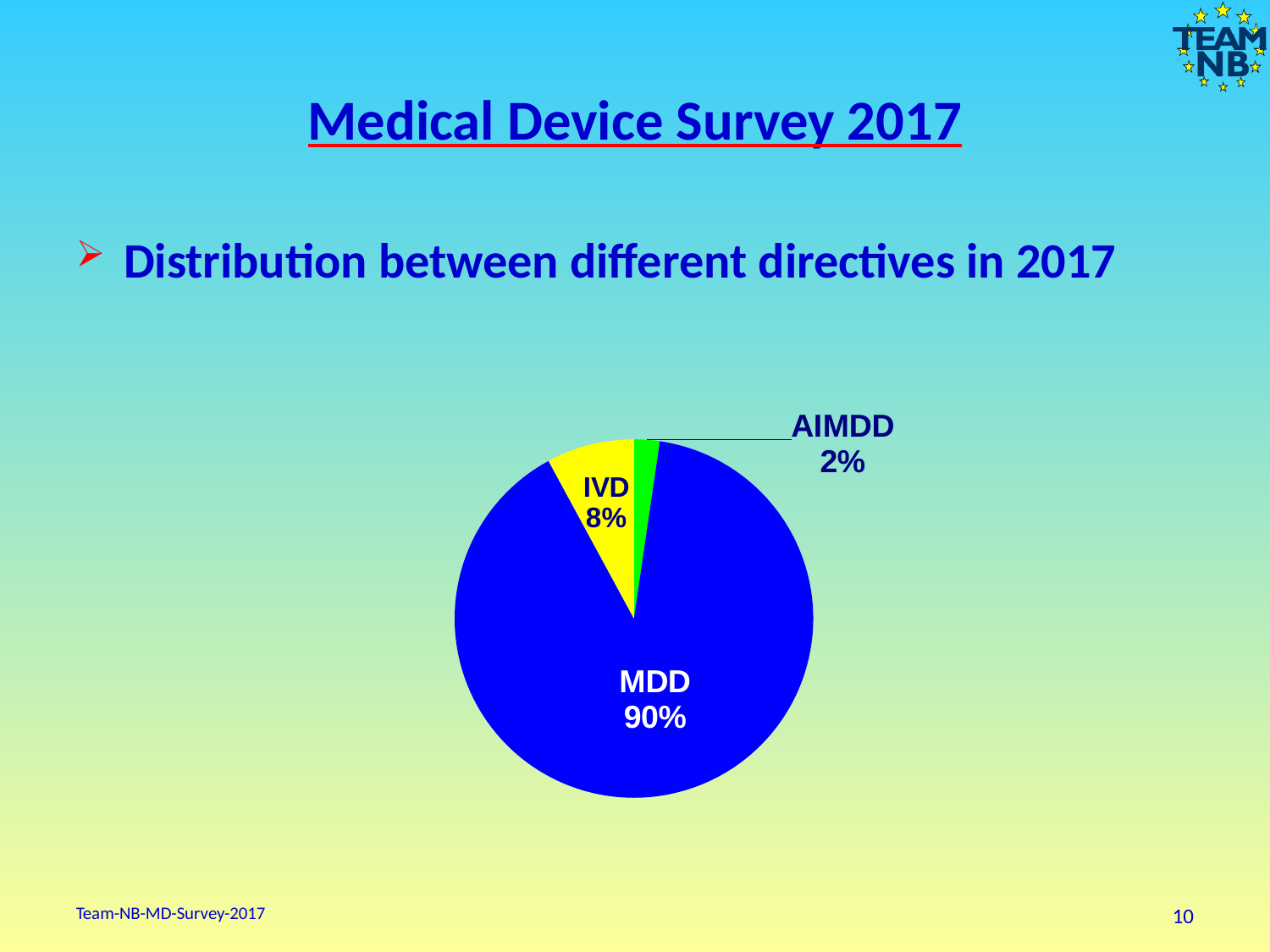
What colour is the MDD slice of the pie? blue What share of the pie does AIMDD represent? 2% What is the difference in percentage points between the MDD and IVD slices? 82 Which slice is larger, IVD or AIMDD? IVD Which directive has the smallest slice of the pie? AIMDD What kind of chart is shown on the slide? pie chart What is the difference in percentage points between the IVD and AIMDD slices? 6 Which directive has the largest slice of the pie? MDD What share of the pie does MDD represent? 90% What share of the pie does IVD represent? 8% What colour is the IVD slice of the pie? yellow How many slices does the pie chart have? 3